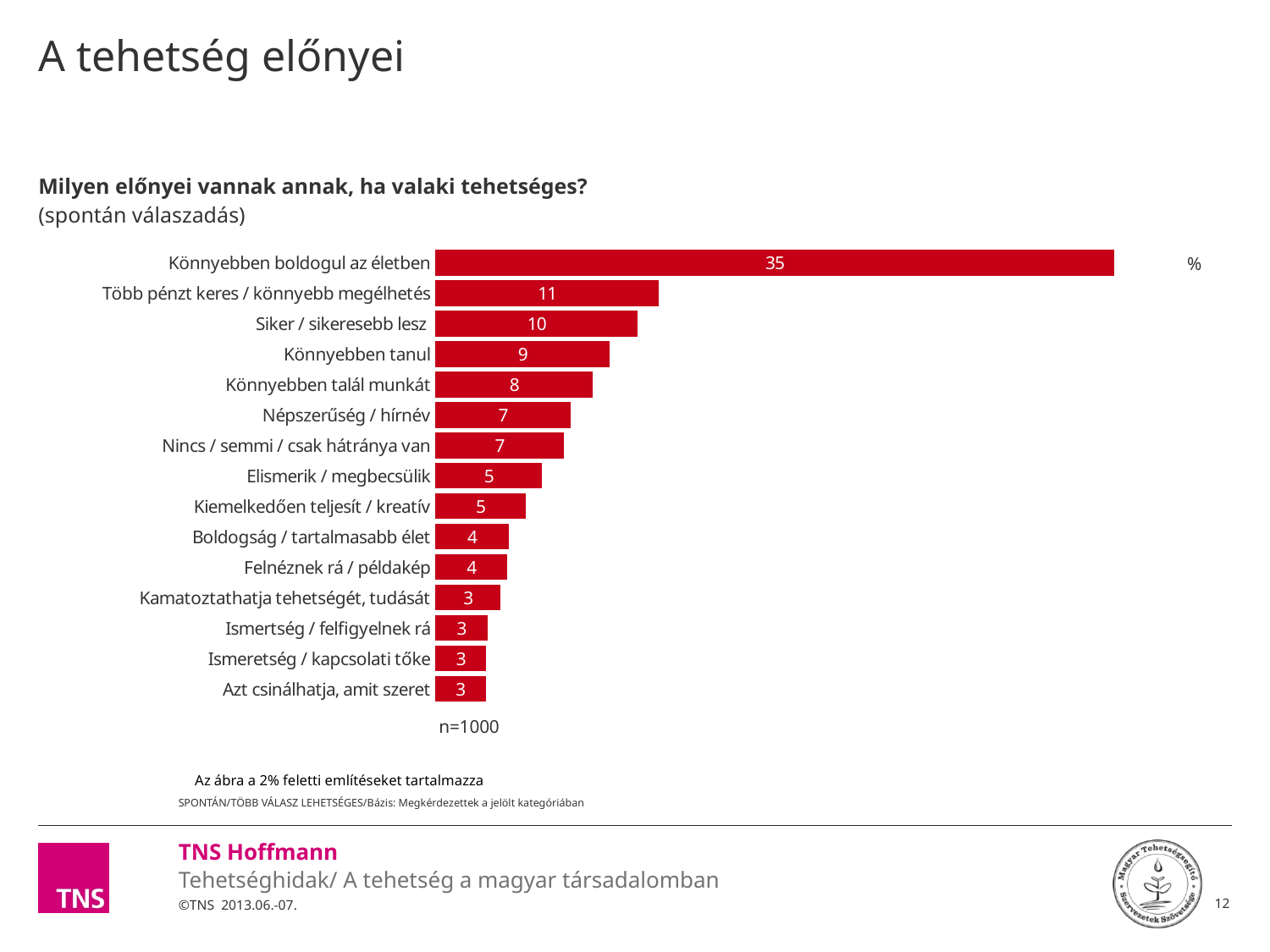
What is the difference between the values for "Könnyebben tanul" and "Boldogság / tartalmasabb élet"? 5 What kind of chart is shown on the slide? Bar chart What is the value for "Siker / sikeresebb lesz"? 10 What is the value for "Elismerik / megbecsülik"? 5 What is the difference between the values for "Könnyebben boldogul az életben" and "Több pénzt keres / könnyebb megélhetés"? 24 What is the value for "Kamatoztathatja tehetségét, tudását"? 3 Which category has the highest value? Könnyebben boldogul az életben What is the value for "Könnyebben talál munkát"? 8 Which is larger: the value for "Siker / sikeresebb lesz" or the value for "Népszerűség / hírnév"? Siker / sikeresebb lesz How many categories are shown in the chart? 15 What is the sample size (n) shown below the chart? n=1000 What is the value for "Könnyebben boldogul az életben"? 35